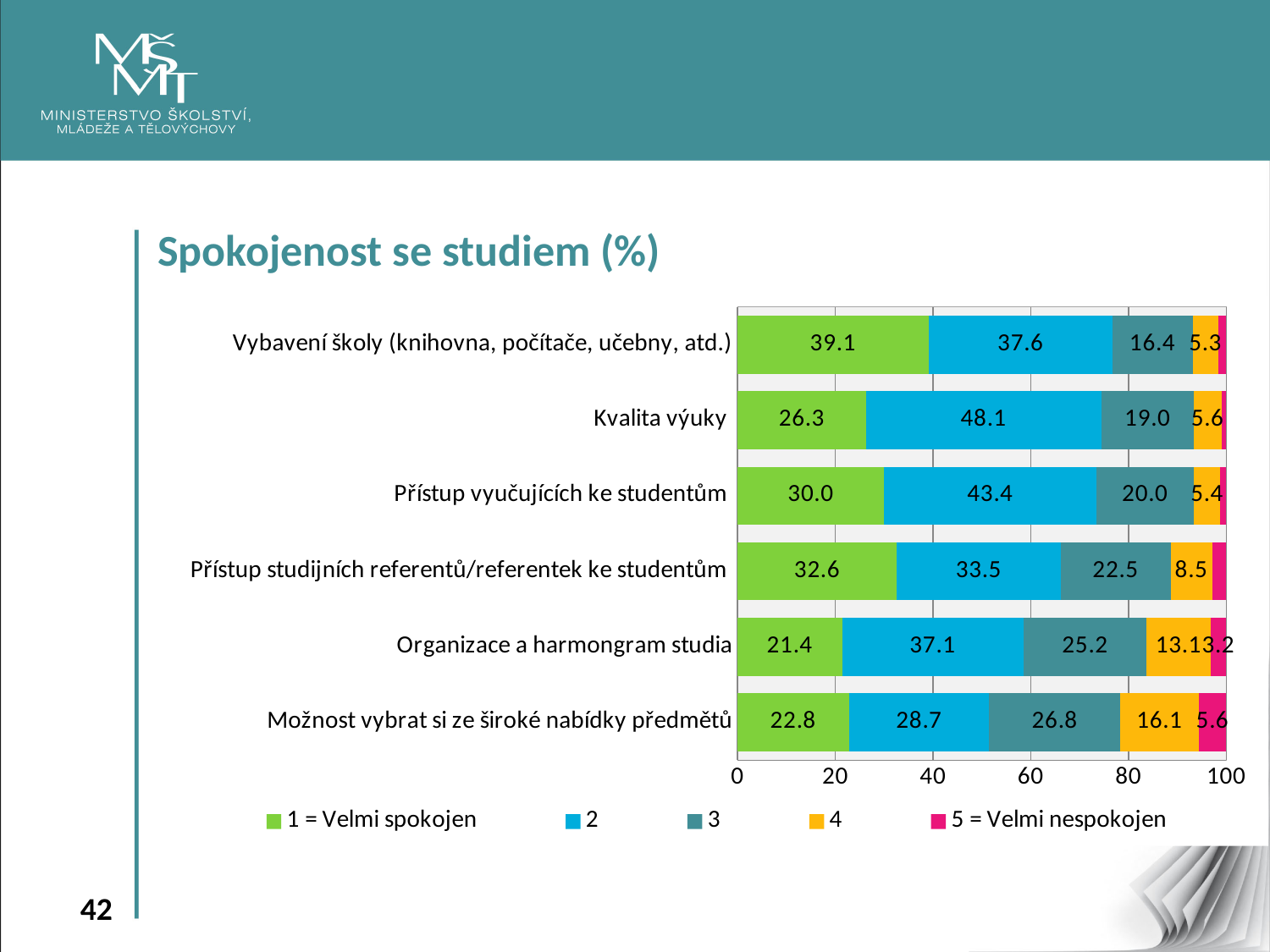
How many series does the legend list? 5 What is the value of series '4' for 'Přístup studijních referentů/referentek ke studentům'? 8.5 What is the title of the chart? Spokojenost se studiem (%) What is the value of '1 = Velmi spokojen' for 'Kvalita výuky'? 26.3 What is the value of series '2' for 'Přístup vyučujících ke studentům'? 43.4 What is the value of '5 = Velmi nespokojen' for 'Možnost vybrat si ze široké nabídky předmětů'? 5.6 How many categories are plotted on the chart? 6 Which category has the lowest value for '1 = Velmi spokojen'? Organizace a harmongram studia What kind of chart is shown on the slide? Stacked bar chart Which category has the highest value for '1 = Velmi spokojen'? Vybavení školy (knihovna, počítače, učebny, atd.) Which is larger for 'Možnost vybrat si ze široké nabídky předmětů': the value of series '2' or series '3'? 2 What is the difference between the series '2' value and the '1 = Velmi spokojen' value for 'Kvalita výuky'? 21.8